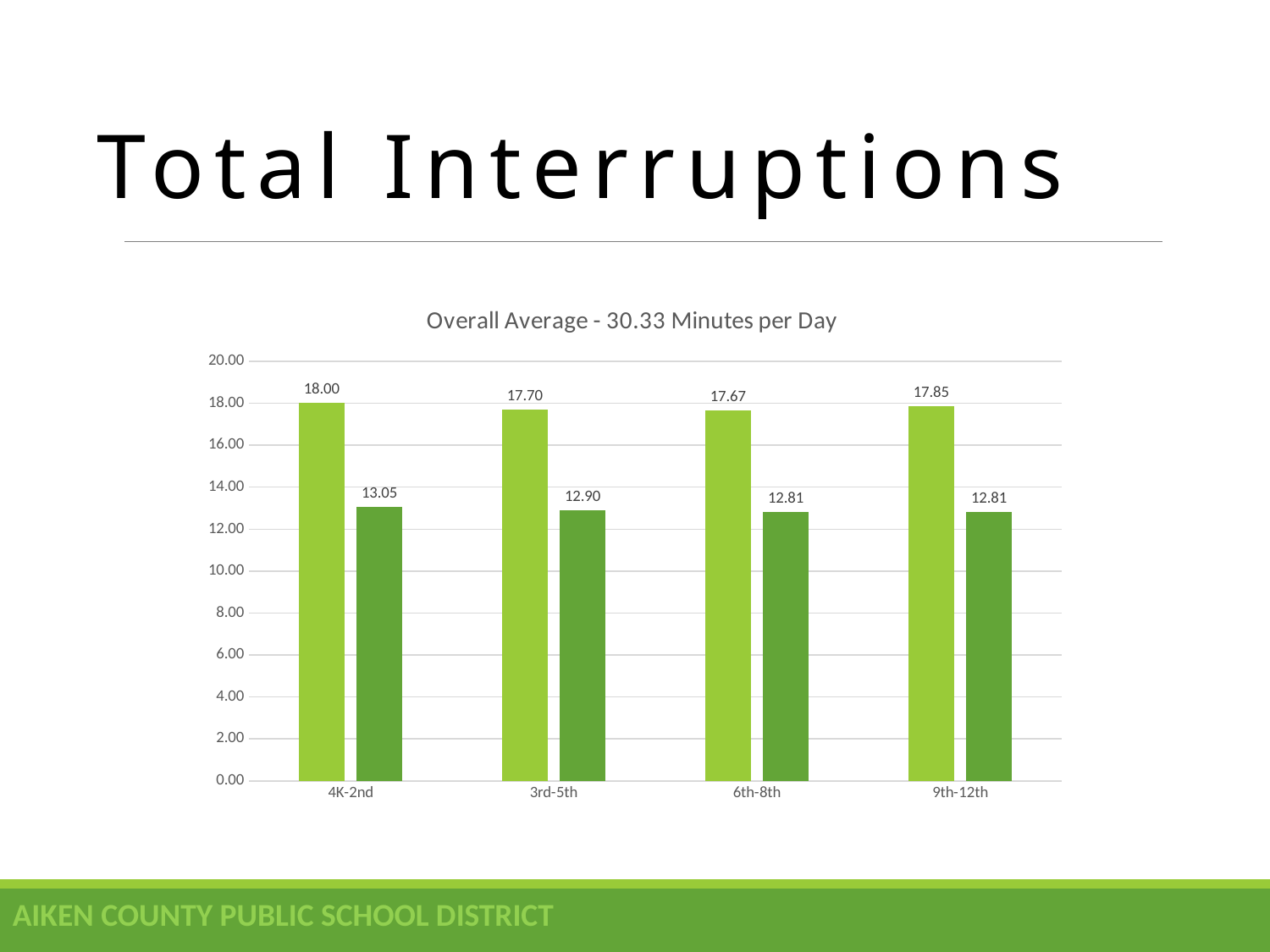
What is the value of the dark green bar for 6th-8th? 12.81 Which is larger, the dark green bar for 4K-2nd or the dark green bar for 3rd-5th? 4K-2nd What is the value of the dark green bar for 3rd-5th? 12.90 What is the value of the light green bar for 9th-12th? 17.85 What is the difference between the light green and dark green bars for 4K-2nd? 4.95 How many grade bands are shown on the x axis? 4 What is the value of the light green bar for 4K-2nd? 18.00 Is the value of the dark green bar for 9th-12th greater or less than 14.00? less Which grade band has the highest light green bar? 4K-2nd What is the difference between the light green bars for 4K-2nd and 9th-12th? 0.15 Which grade band has the highest dark green bar? 4K-2nd What is the title of the chart? Overall Average - 30.33 Minutes per Day